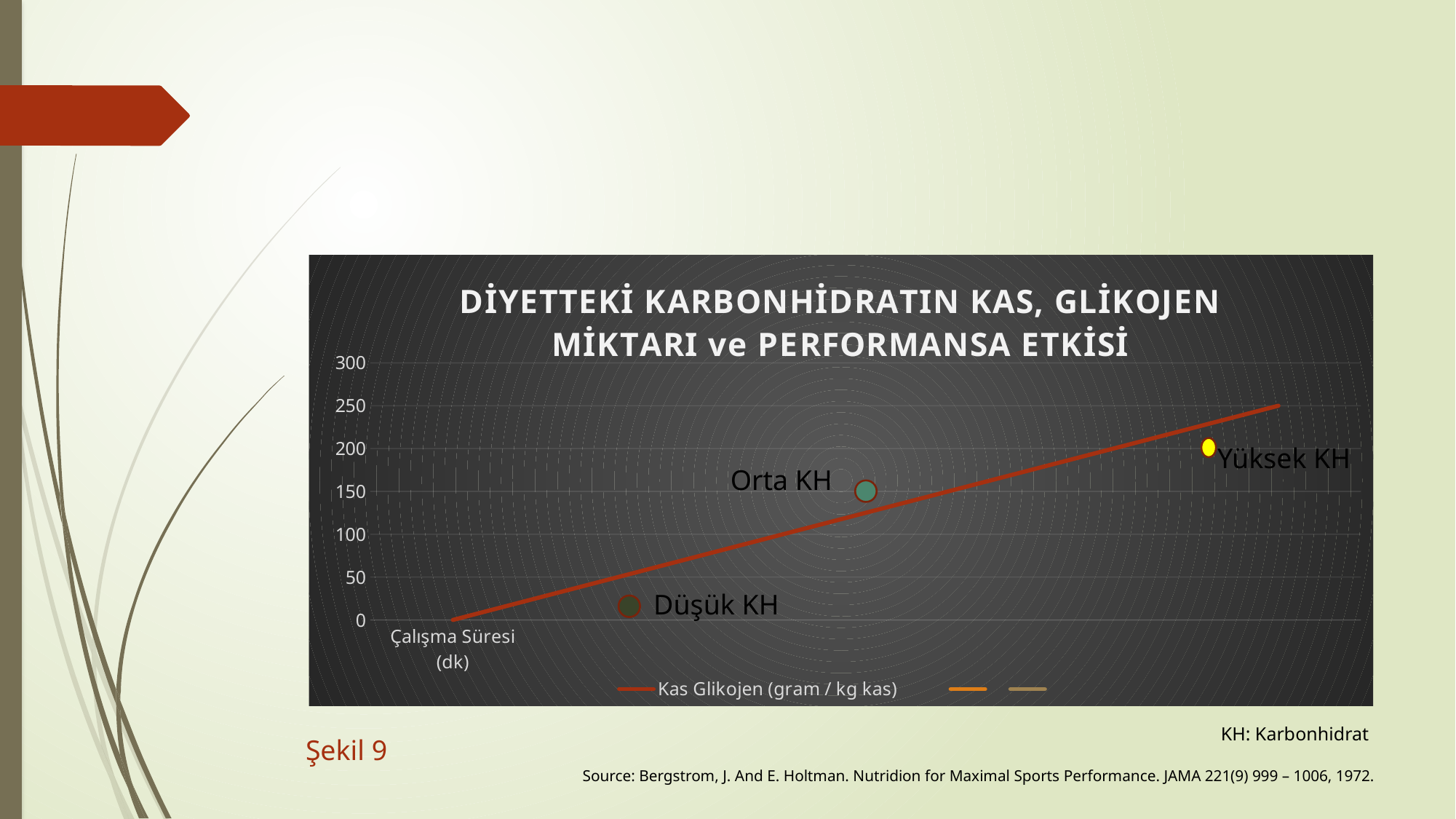
Is the value for the Yüksek KH point greater or less than 150? greater Which of the labelled points (Düşük KH, Orta KH, Yüksek KH) is the lowest? Düşük KH What kind of chart is shown on the slide? line chart What is the name of the series shown in the legend with the red line? Kas Glikojen (gram / kg kas) What is the title of the chart? DİYETTEKİ KARBONHİDRATIN KAS, GLİKOJEN MİKTARI ve PERFORMANSA ETKİSİ Is the value for the Orta KH point greater or less than 100? greater Which of the labelled points (Düşük KH, Orta KH, Yüksek KH) is the highest? Yüksek KH How many labelled points (Düşük KH, Orta KH, Yüksek KH) are marked on the chart? 3 Which is larger, the value for Orta KH or the value for Düşük KH? Orta KH Does the Kas Glikojen line rise or fall along the x axis? rises Is the value for the Yüksek KH point greater or less than 250? less